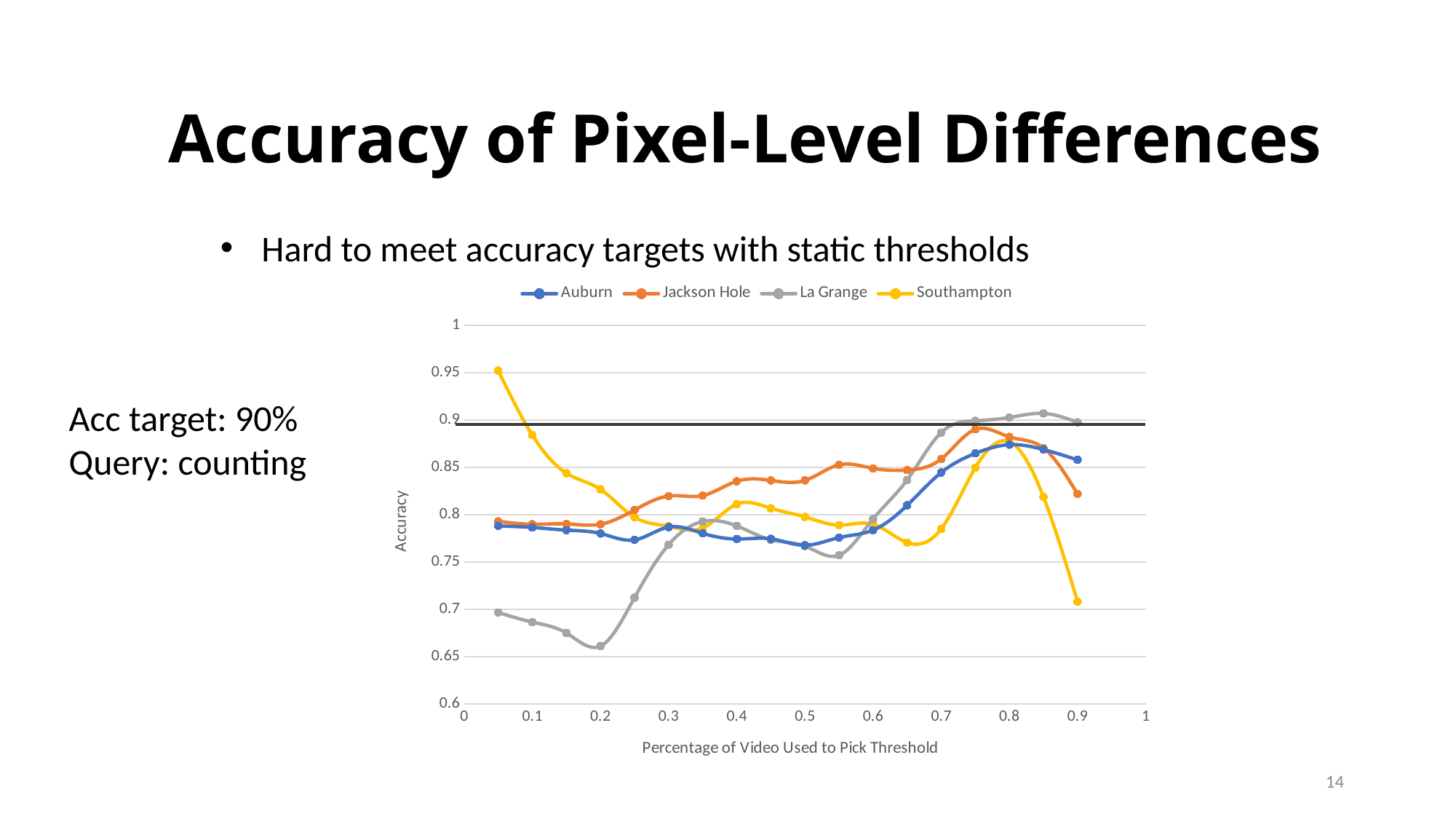
Which series has the lowest value at x = 0.05? La Grange Is the value for Southampton at x = 0.9 greater or less than 0.75? less Is the value for Jackson Hole at x = 0.4 greater or less than 0.8? greater Is the value for La Grange at x = 0.2 greater or less than 0.7? less Does the La Grange line rise or fall between x = 0.2 and x = 0.85? rise What is the title of the y axis? Accuracy At x = 0.9, which is larger: Auburn or Southampton? Auburn What is the title of the x axis? Percentage of Video Used to Pick Threshold How many series does the legend list? 4 Which series has the highest value at x = 0.05? Southampton What kind of chart is shown on the slide? line chart